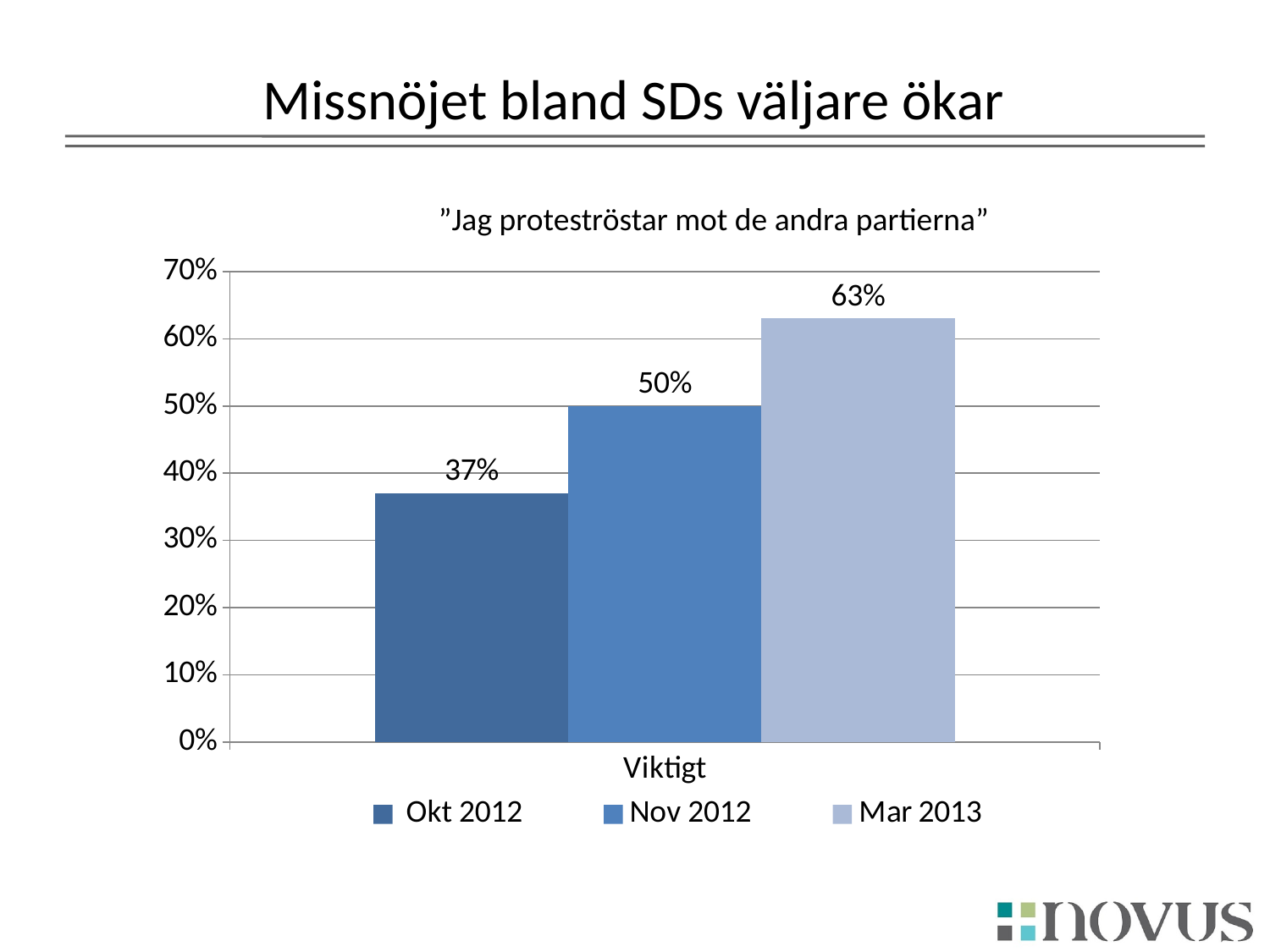
What is the value for Nov 2012? 50% What is the title of the chart? "Jag proteströstar mot de andra partierna" Which series has the lowest value? Okt 2012 What is the difference between the Mar 2013 and Okt 2012 values? 26% Which is larger, the value for Nov 2012 or the value for Mar 2013? Mar 2013 What kind of chart is shown on the slide? Bar chart How many series does the legend list? 3 Do the values rise or fall from Okt 2012 to Mar 2013? Rise What is the value for Mar 2013? 63% What is the value for Okt 2012? 37% Which series has the highest value? Mar 2013 What is the difference between the Nov 2012 and Okt 2012 values? 13%